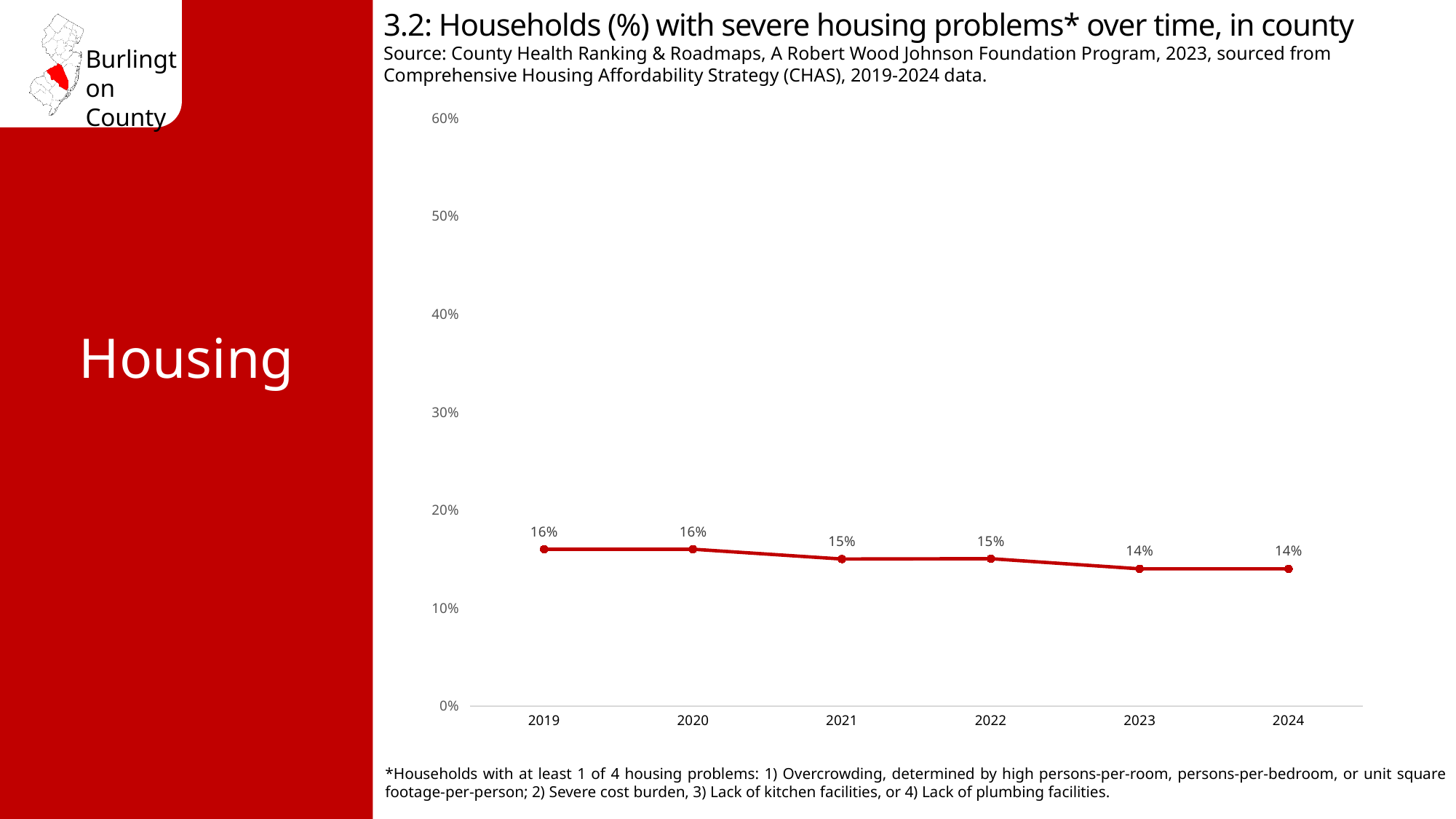
Which is larger, the value for 2020 or the value for 2023? 2020 What is the difference between the 2019 value and the 2024 value? 2% What percentage of households had severe housing problems in 2024? 14% What percentage of households had severe housing problems in 2021? 15% Do the values rise or fall from 2019 to 2024? fall Is the value for 2022 greater or less than 20%? less What is the title of the chart? 3.2: Households (%) with severe housing problems* over time, in county How many years are plotted on the chart? 6 What is the lowest value shown on the chart? 14% What kind of chart is shown on the slide? line chart What is the highest value shown on the chart? 16% What percentage of households had severe housing problems in 2019? 16%